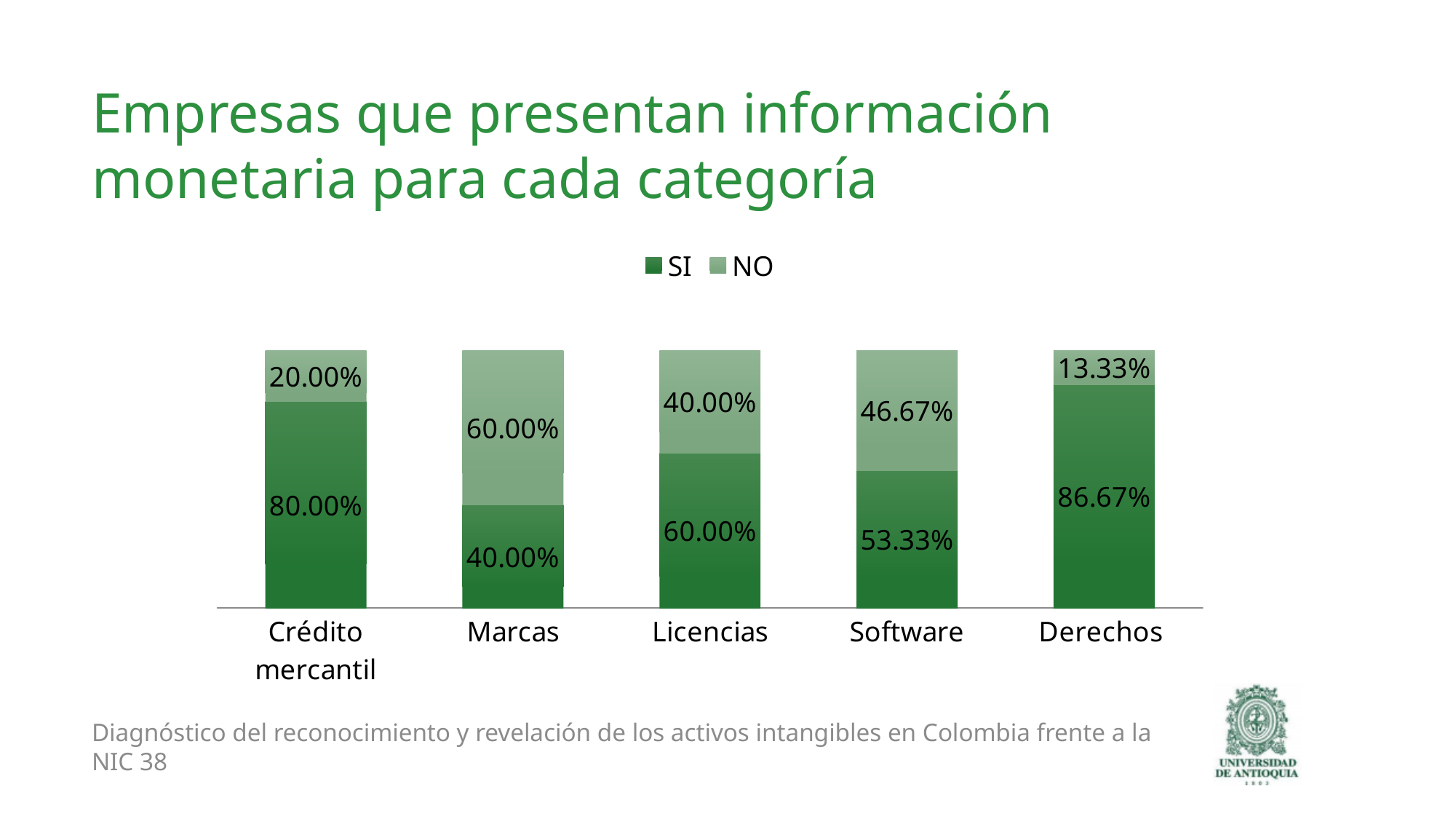
What is the NO value for Marcas? 60.00% Which is larger, the SI value for Licencias or the SI value for Software? Licencias How many series does the legend list? 2 What kind of chart is shown on the slide? Stacked bar chart What is the total of the stacked bar for Licencias? 100.00% What is the difference between the SI value for Derechos and the SI value for Marcas? 46.67% Which category has the highest SI value? Derechos How many categories are shown on the x axis? 5 What is the NO value for Derechos? 13.33% What is the SI value for Software? 53.33% What is the SI value for Crédito mercantil? 80.00% Which category has the lowest SI value? Marcas